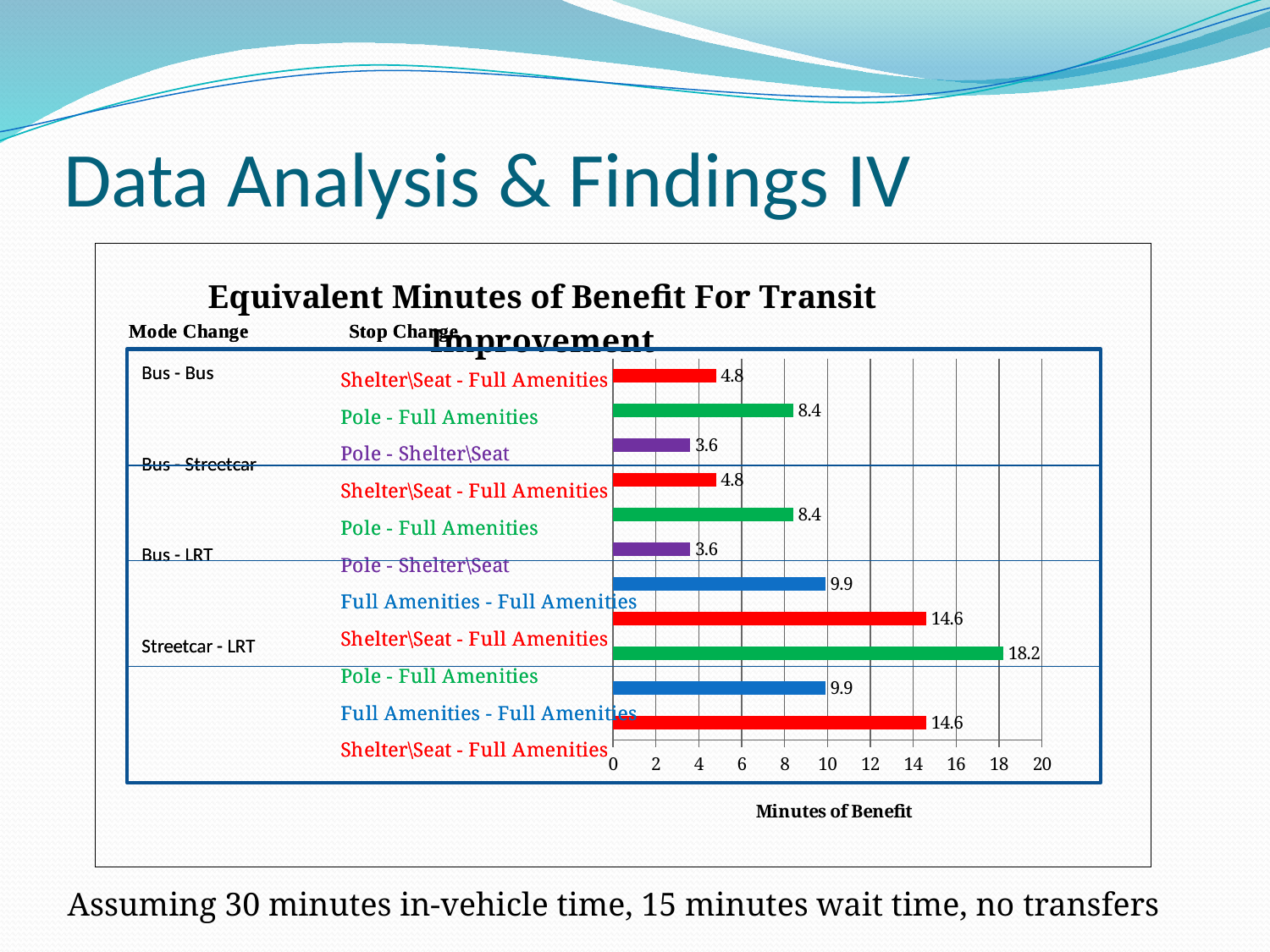
Is the value of the longest bar greater or less than 18? greater What is the value of the longest bar in the chart? 18.2 What is the value of the shortest bars in the chart? 3.6 What is the value of the topmost bar in the chart (Bus - Bus, Shelter\Seat - Full Amenities)? 4.8 Which is larger, the bar labelled 9.9 or the bar labelled 14.6 in the Bus - LRT group? 14.6 What is the difference between the 14.6 bar and the 9.9 bar? 4.7 How many bars are plotted in the chart? 11 What is the label on the horizontal axis of the chart? Minutes of Benefit What kind of chart is shown on the slide? bar chart What is the title of the chart? Equivalent Minutes of Benefit For Transit Improvement What is the value of the first green bar (Bus - Bus, Pole - Full Amenities)? 8.4 What is the difference between the longest bar (18.2) and the shortest bar (3.6)? 14.6